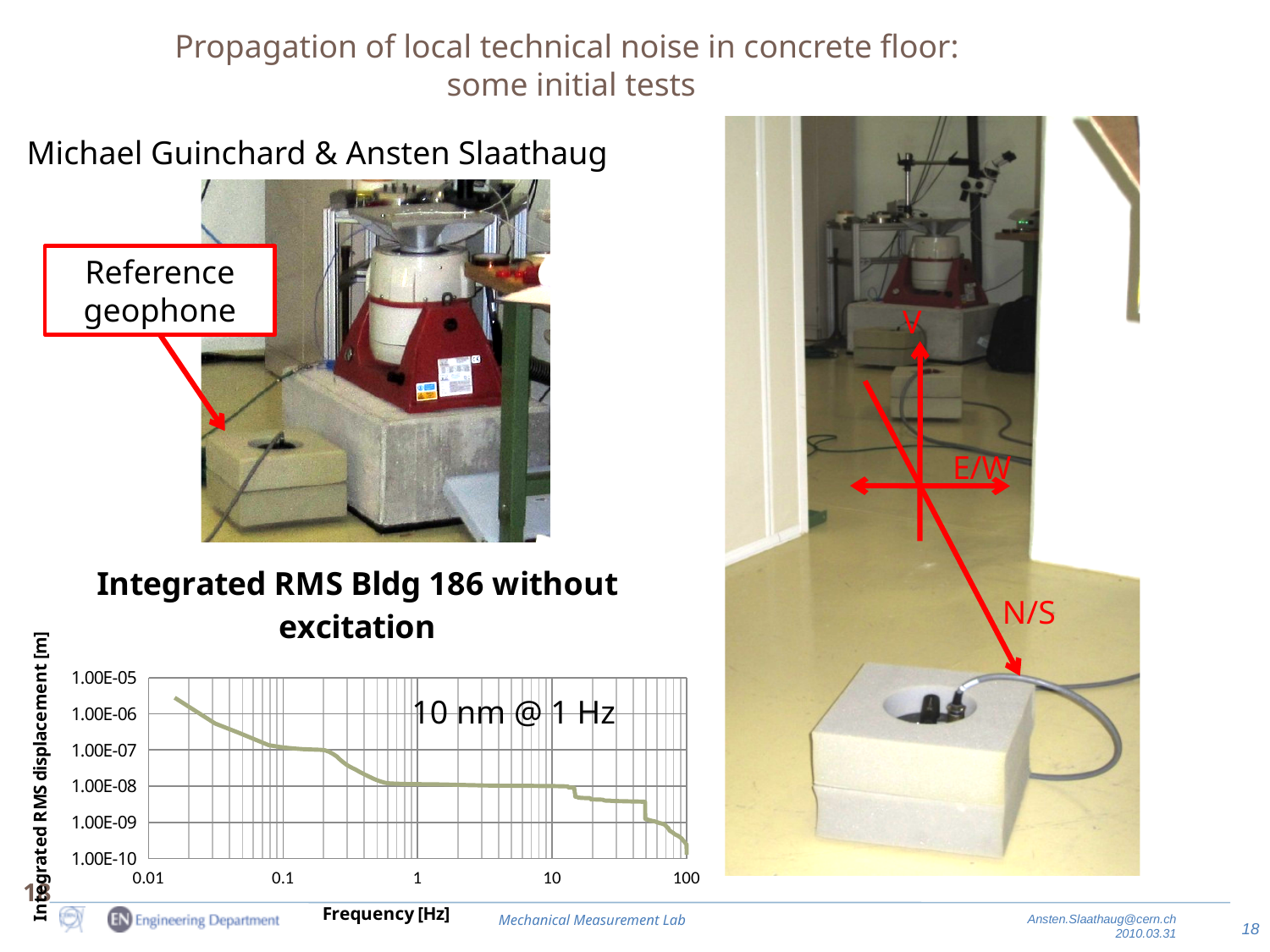
What is the label of the x axis of the chart? Frequency [Hz] What is the title of the chart? Integrated RMS Bldg 186 without excitation What kind of chart is shown on the slide? line chart Is the value of the line at 1 Hz greater or less than 1.00E-07? less Is the value of the line at its leftmost point (near 0.01 Hz) greater or less than 1.00E-06? greater Is the value of the line at 100 Hz greater or less than 1.00E-08? less Which is larger, the value of the line at 0.1 Hz or at 10 Hz? 0.1 Hz According to the annotation on the chart, what is the integrated RMS displacement at 1 Hz? 10 nm Does the plotted line rise or fall as frequency increases along the x axis? fall What is the highest tick value shown on the y axis? 1.00E-05